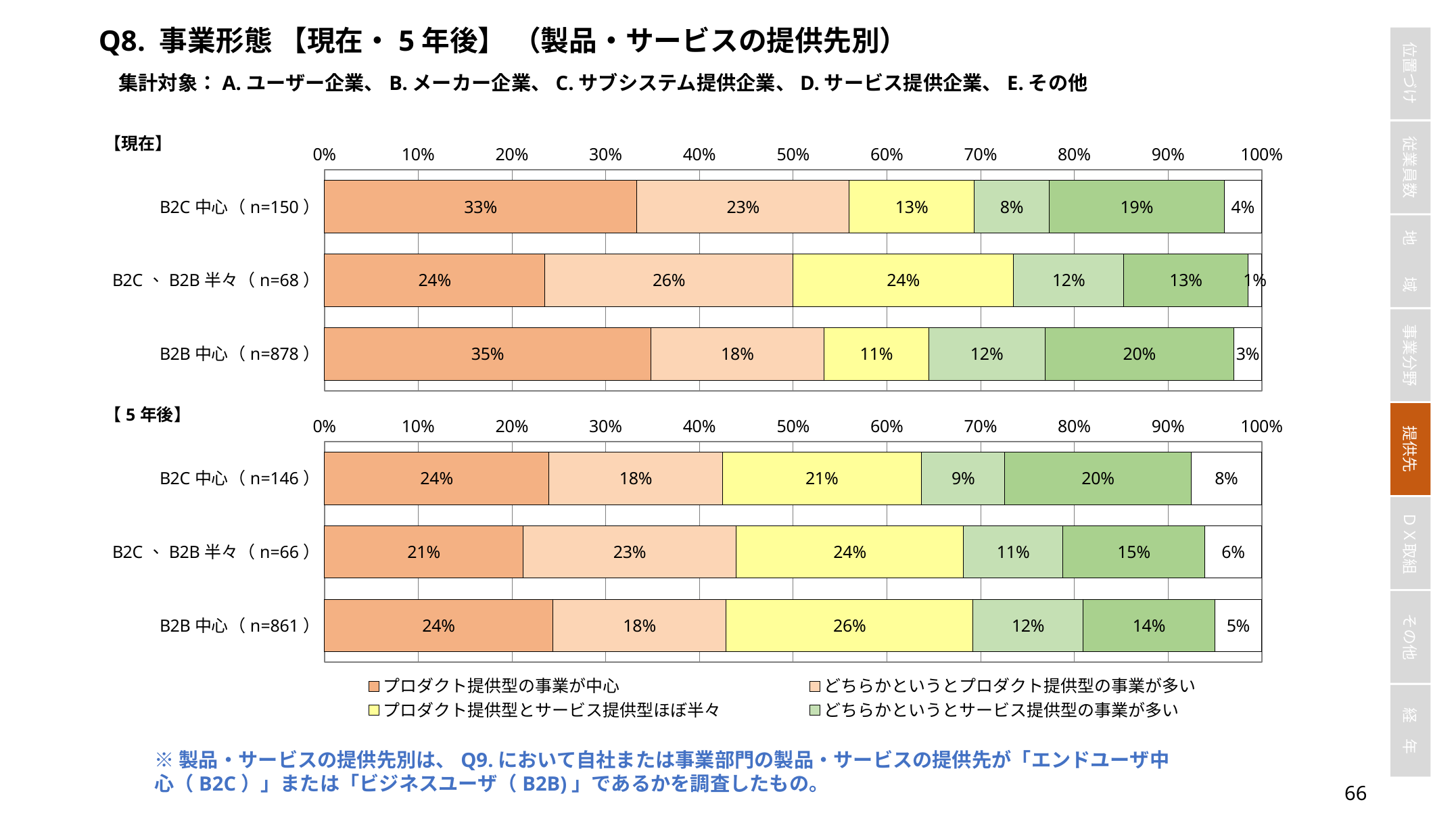
In the 【現在】 chart, what is the value of どちらかというとサービス提供型の事業が多い for B2C、B2B 半々 (n=68)? 12% What kind of chart is the 【現在】 chart? Stacked bar chart In the 【5年後】 chart, what is the value of プロダクト提供型とサービス提供型ほぼ半々 for B2B 中心 (n=861)? 26% In the 【5年後】 chart, what is the value of どちらかというとプロダクト提供型の事業が多い for B2C、B2B 半々 (n=66)? 23% What is the sample size (n) for B2C 中心 in the 【5年後】 chart? 146 In the 【現在】 chart, what is the difference between the プロダクト提供型の事業が中心 values for B2B 中心 and B2C、B2B 半々? 11% In the 【現在】 chart, which category has the highest value for プロダクト提供型の事業が中心? B2B 中心 (n=878) How many entries does the legend below the charts list? 4 How many categories (bars) are shown in the 【5年後】 chart? 3 In the 【現在】 chart, what is the value of プロダクト提供型の事業が中心 for B2C 中心 (n=150)? 33% In the 【現在】 chart, which is larger for プロダクト提供型とサービス提供型ほぼ半々: B2C、B2B 半々 or B2B 中心? B2C、B2B 半々 In the 【5年後】 chart, which category has the lowest value for どちらかというとサービス提供型の事業が多い? B2C 中心 (n=146)